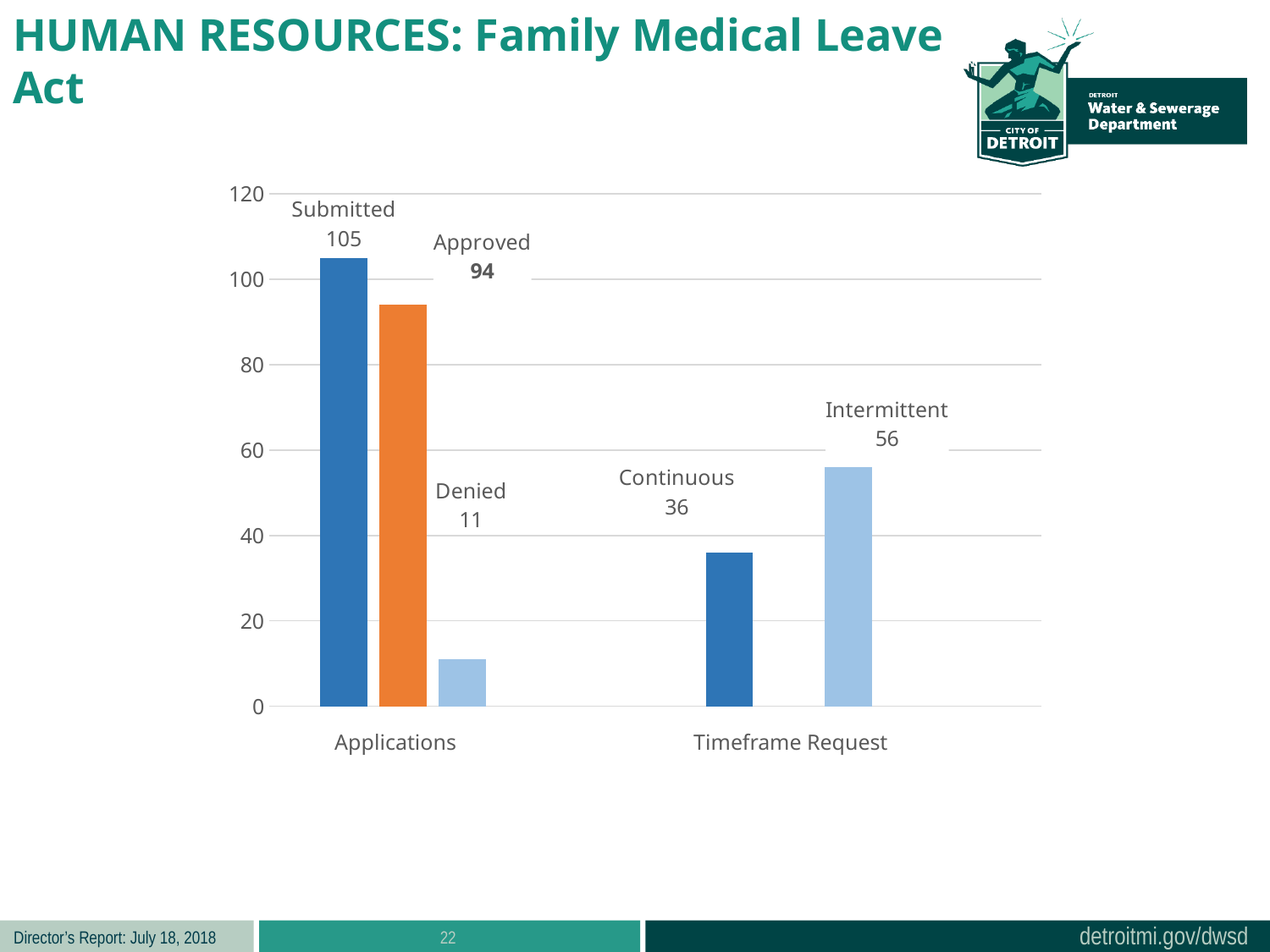
What type of chart is shown on the slide? Bar chart What is the value for Continuous under Timeframe Request? 36 What is the difference between Submitted and Approved applications? 11 How many applications were approved? 94 What is the difference between Intermittent and Continuous timeframe requests? 20 How many category groups are shown on the x axis? 2 Which bar has the highest value on the chart? Submitted What is the value for Intermittent under Timeframe Request? 56 How many Family Medical Leave Act applications were submitted? 105 Which is larger, Continuous or Intermittent? Intermittent How many applications were denied? 11 Which bar has the lowest value on the chart? Denied